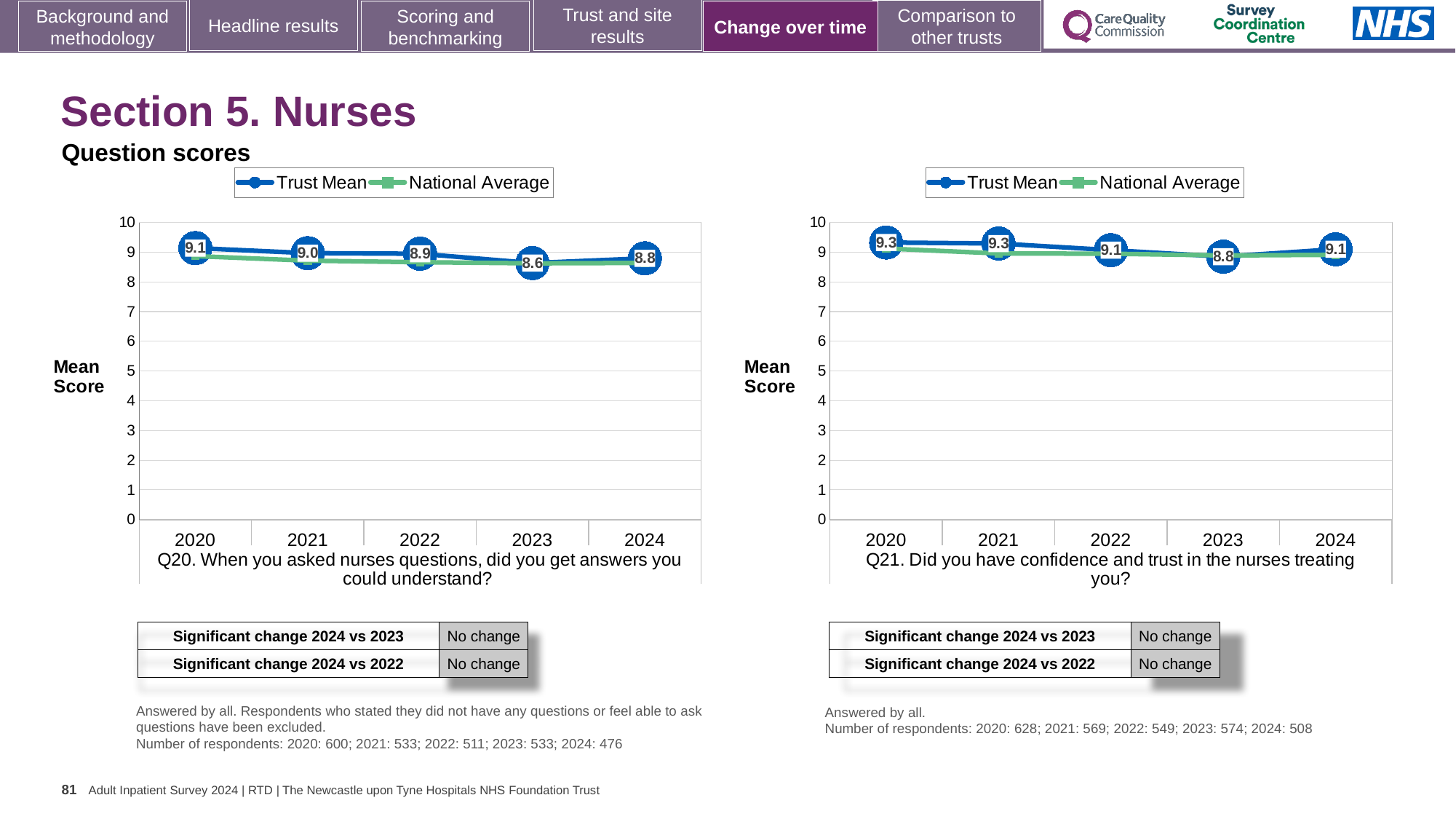
What type of chart is the Q20 chart on the left? Line chart In the Q21 chart on the right, is the Trust Mean score for 2021 higher or lower than for 2022? higher In the Q20 chart on the left, what is the Trust Mean score for 2022? 8.9 In the Q21 chart on the right, what is the Trust Mean score for 2023? 8.8 In the Q20 chart on the left, is the National Average for 2023 greater or less than 9? less In the Q21 chart on the right, what is the Trust Mean score for 2024? 9.1 In the Q20 chart on the left, what is the Trust Mean score for 2024? 8.8 How many series does the legend of the Q21 chart on the right list? 2 In the Q20 chart on the left, what is the difference between the Trust Mean scores for 2020 and 2023? 0.5 In the Q20 chart on the left, which year has the highest Trust Mean score? 2020 In the Q20 chart on the left, which year has the lowest Trust Mean score? 2023 In the Q21 chart on the right, which year has the lowest Trust Mean score? 2023